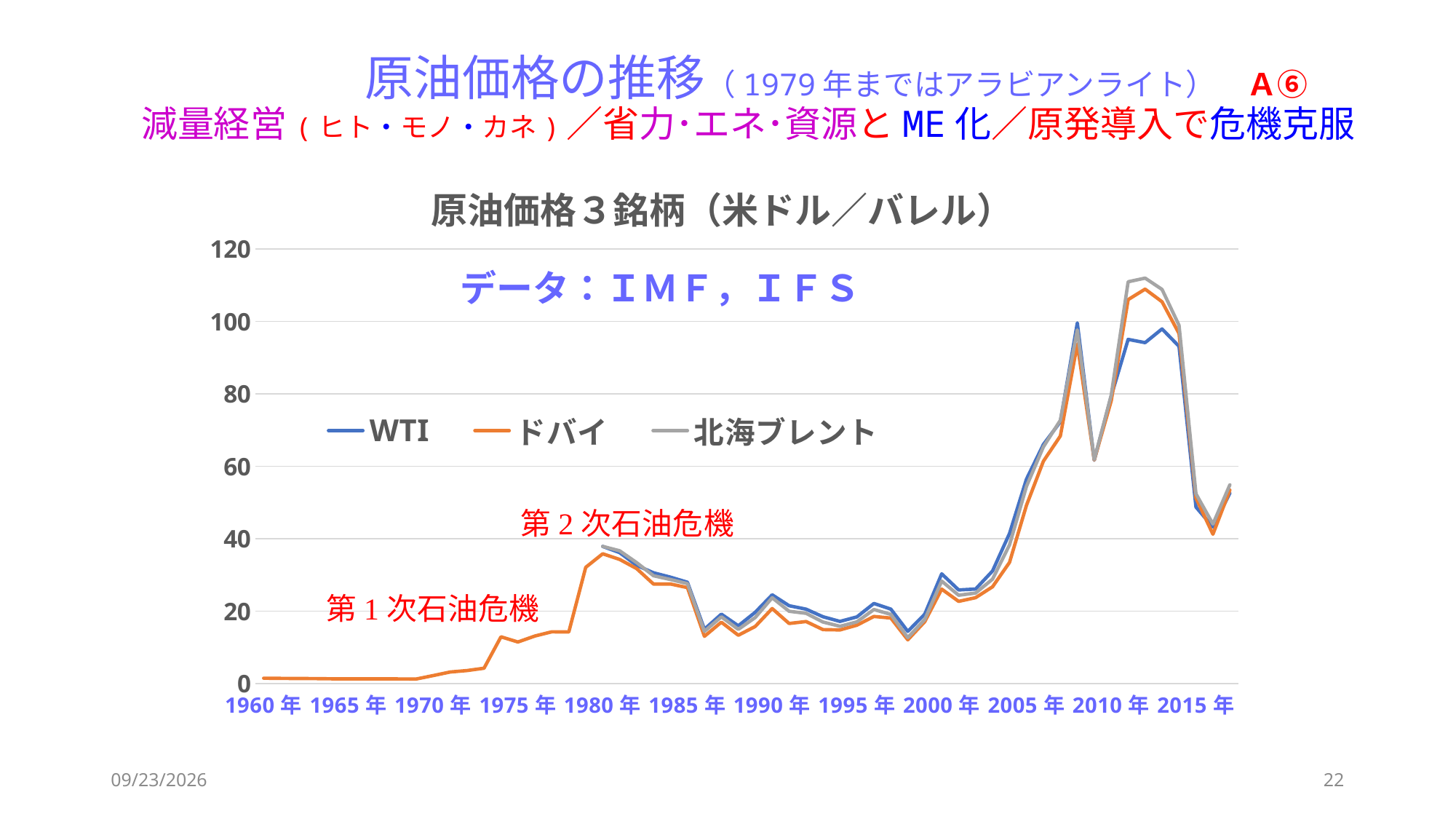
Is the value for ドバイ in 1980年 greater or less than 40? less Is the value for ドバイ in 1960年 greater or less than 20? less Is the value for WTI in 2008年 greater or less than 80? greater What kind of chart is shown on the slide? line chart Do the oil prices rise or fall between 2012年 and 2016年? fall What is the title of the chart? 原油価格３銘柄（米ドル／バレル） How many series does the chart's legend list? 3 What are the three series named in the chart's legend? WTI, ドバイ, 北海ブレント Do the oil prices rise or fall between 1970年 and 1980年? rise